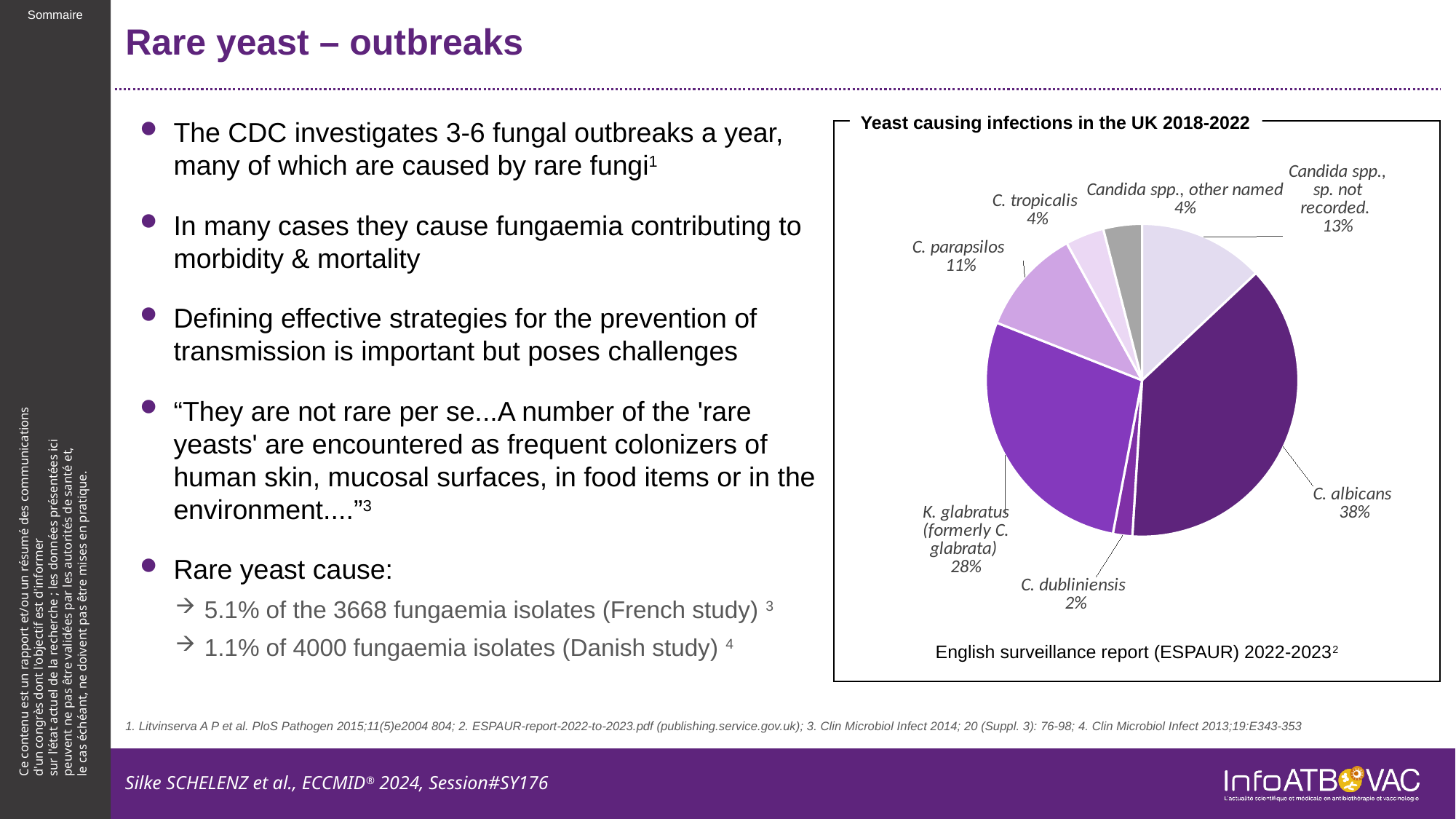
How many slices does the pie chart have? 7 What is the difference in percentage points between C. albicans and K. glabratus (formerly C. glabrata)? 10 What percentage is shown for C. parapsilos? 11% What share of the pie does C. albicans represent? 38% What is the combined share of C. tropicalis and Candida spp., other named? 8% Which yeast has the smallest slice of the pie? C. dubliniensis Which yeast has the largest slice of the pie? C. albicans Which is larger, the share for C. parapsilos or the share for C. tropicalis? C. parapsilos What type of chart is shown on the slide? Pie chart What percentage is shown for Candida spp., sp. not recorded? 13% What is the title of the chart? Yeast causing infections in the UK 2018-2022 What percentage is shown for K. glabratus (formerly C. glabrata)? 28%